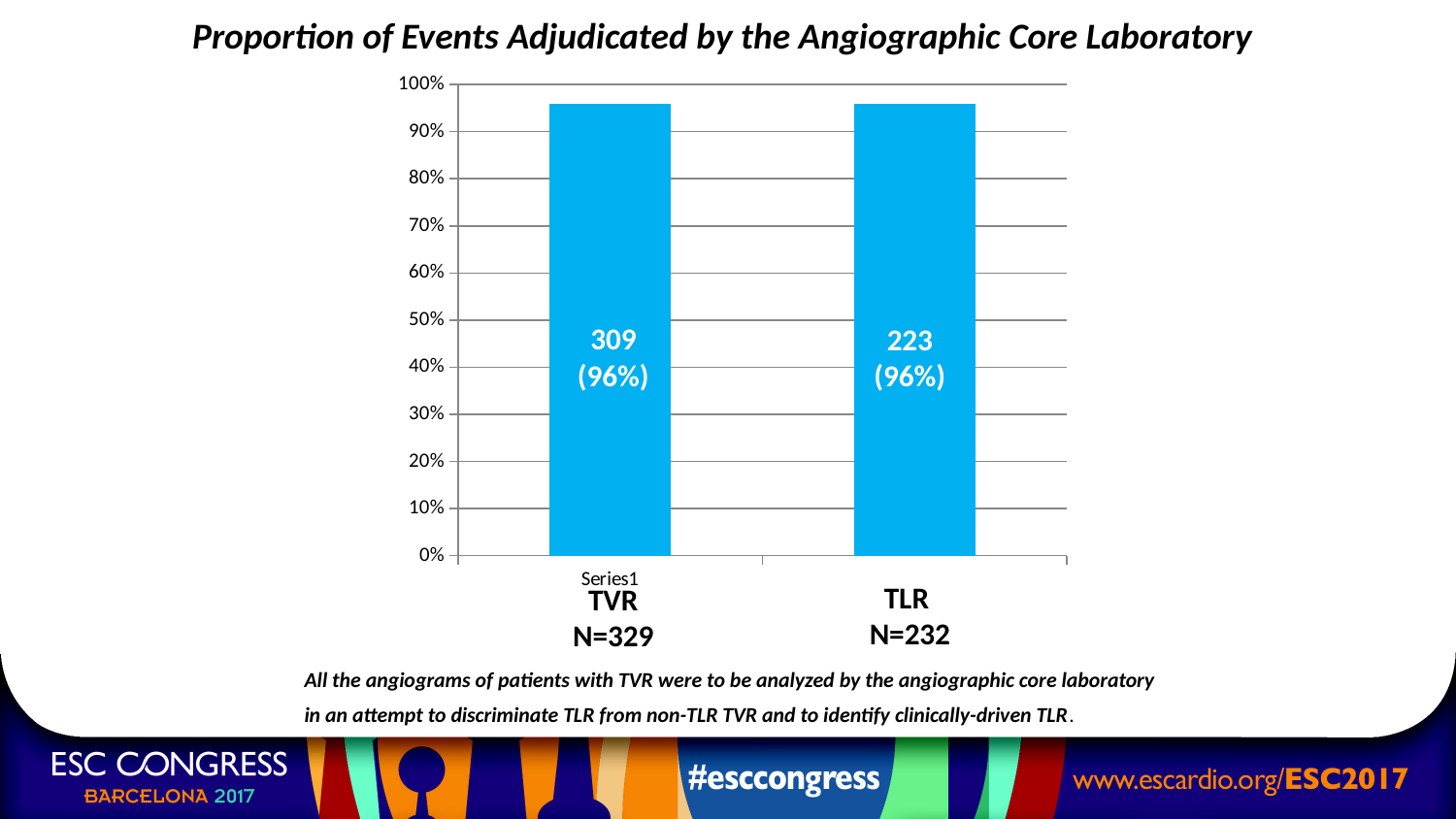
How many TVR events were adjudicated by the angiographic core laboratory, according to the bar label? 309 What is the total number of patients (N) in the TVR group shown under the x axis? N=329 What is the title of the chart? Proportion of Events Adjudicated by the Angiographic Core Laboratory What percentage of TVR events were adjudicated by the angiographic core laboratory? 96% What is the difference between the number of adjudicated TVR events and adjudicated TLR events? 86 Which group has more adjudicated events, TVR or TLR? TVR How many TLR events were adjudicated by the angiographic core laboratory, according to the bar label? 223 What percentage of TLR events were adjudicated by the angiographic core laboratory? 96% Is the proportion of adjudicated TVR events greater or less than 90%? greater What type of chart is shown on the slide? Bar chart How many categories are shown on the x axis of the chart? 2 What is the total number of patients (N) in the TLR group shown under the x axis? N=232